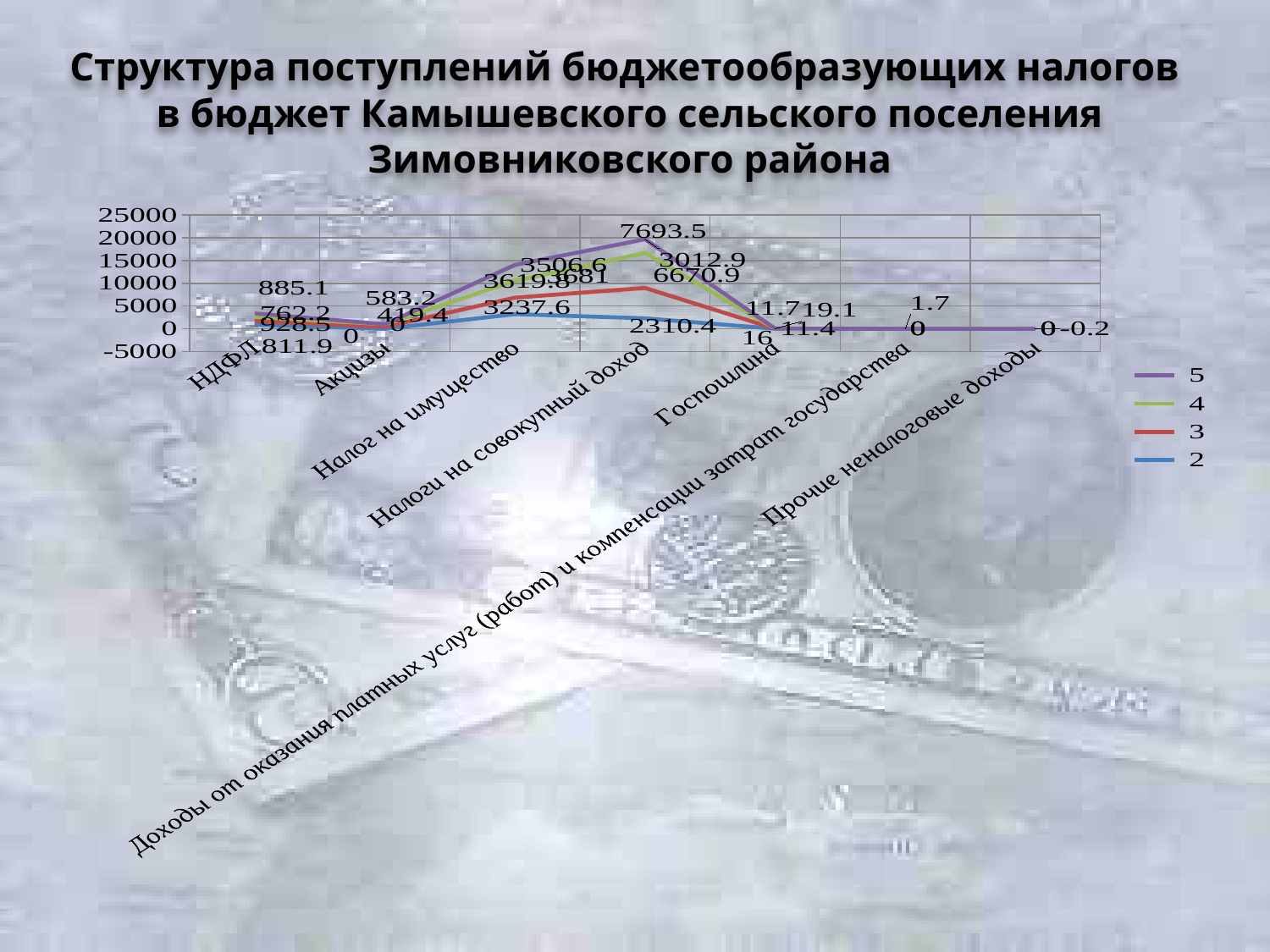
What is the value for series 4 at Налоги на совокупный доход? 7693.5 Which category has the highest value for series 5? Налог на имущество What is the value for series 2 at Налоги на совокупный доход? 2310.4 How many categories are shown along the x axis of the chart? 7 What are the legend entries of the chart? 5, 4, 3, 2 What kind of chart is shown on the slide? line chart What is the difference between the values for series 5 and series 2 at Налоги на совокупный доход? 702.5 What is the value for series 5 at Налоги на совокупный доход? 3012.9 At Налоги на совокупный доход, which is larger: the value for series 3 or the value for series 2? series 3 What is the value for series 3 at Налоги на совокупный доход? 6670.9 How many series does the chart legend list? 4 Do the values for series 5 rise or fall from Налоги на совокупный доход to Госпошлина? fall